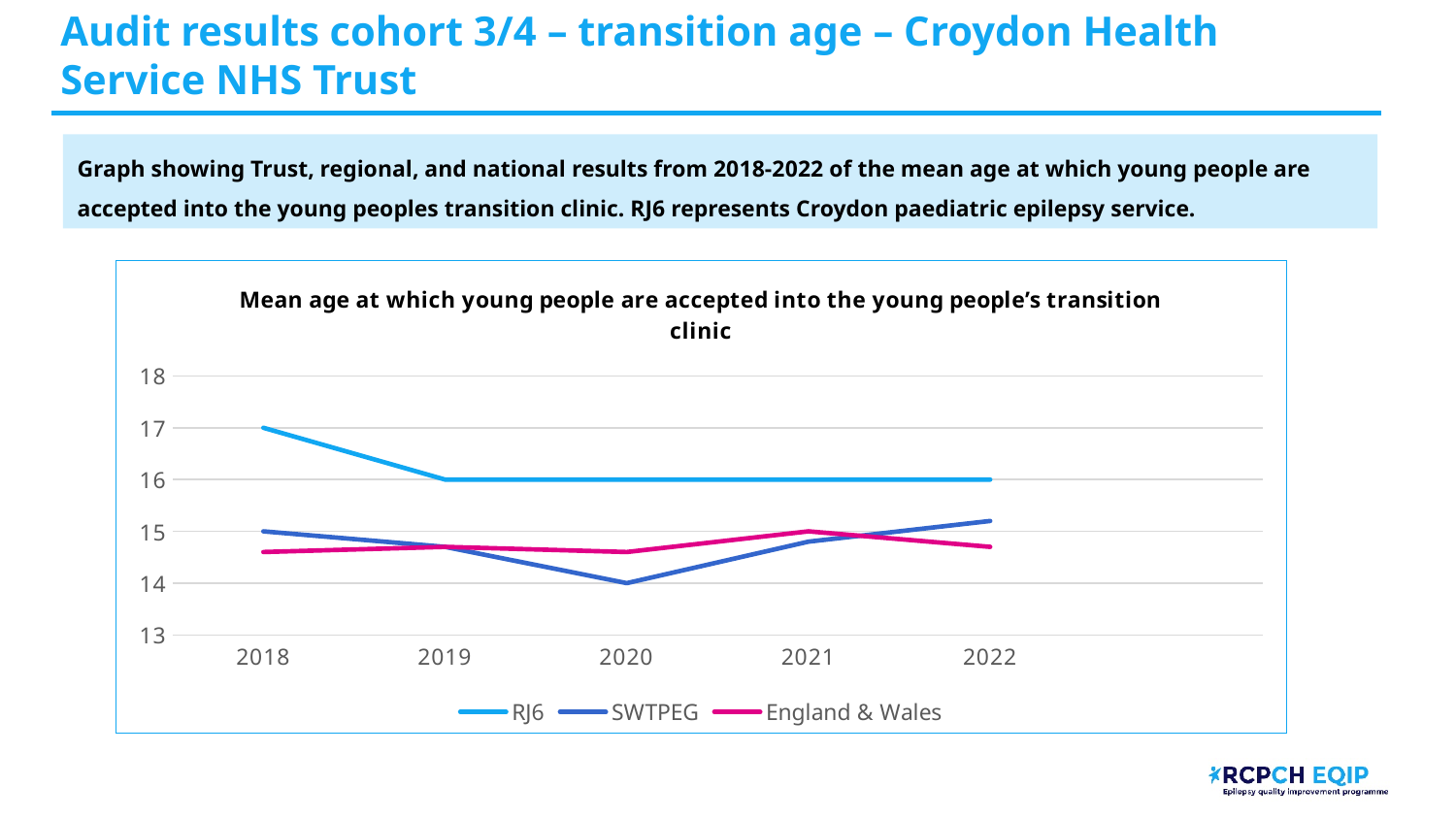
What is the difference between the RJ6 value in 2018 and in 2019? 1 How many series does the legend list? 3 Which series has the lowest value in 2020? SWTPEG What is the value for SWTPEG in 2020? 14 Is the value for England & Wales in 2022 greater or less than 15? less What is the value for SWTPEG in 2018? 15 Which series has the highest value in 2018? RJ6 Does the RJ6 line rise or fall from 2018 to 2019? fall How many years are plotted along the x axis? 5 What is the value for RJ6 in 2019? 16 What is the value for RJ6 in 2018? 17 What kind of chart is shown on the slide? line chart